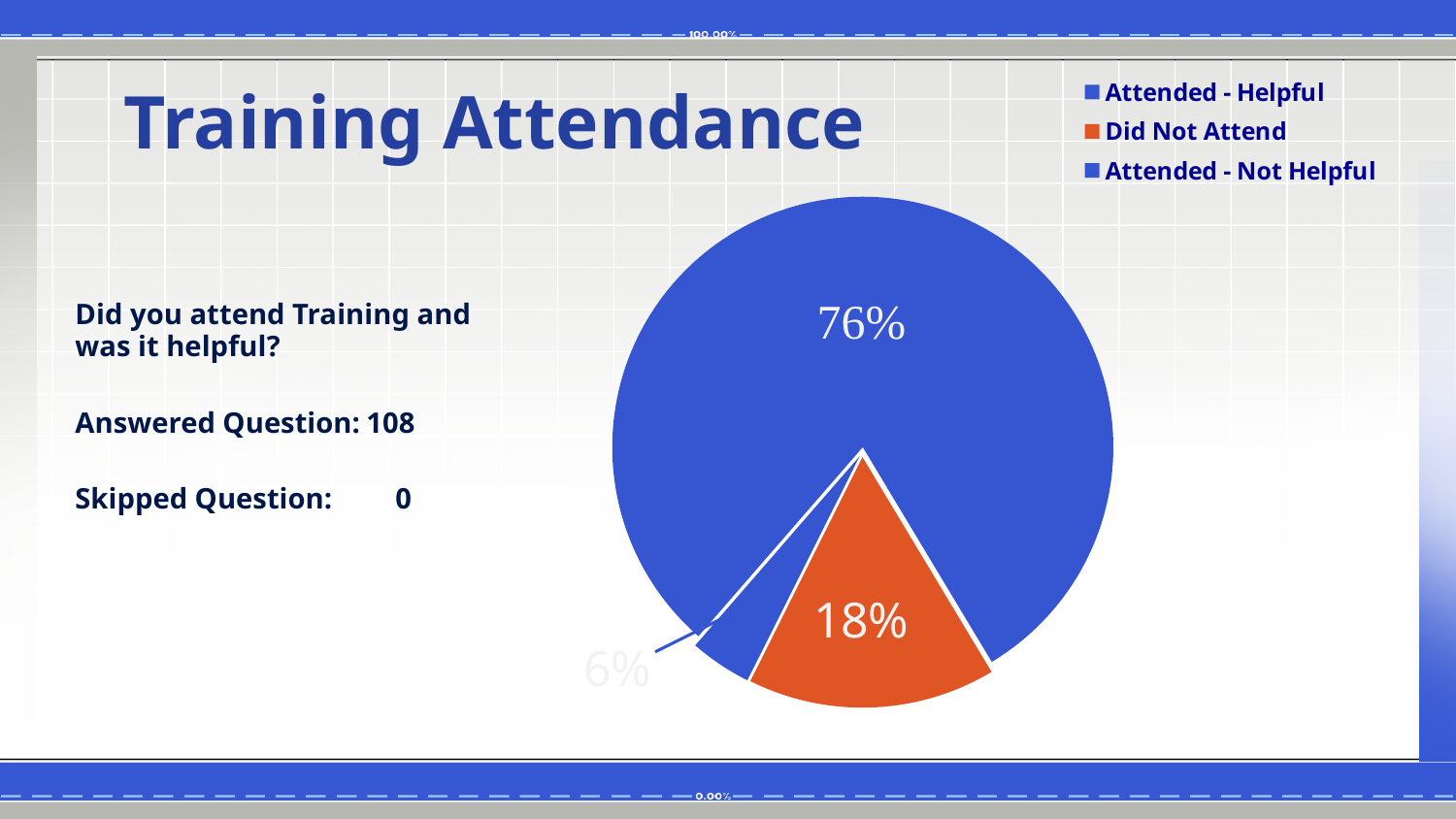
What is the difference in percentage points between Attended - Helpful and Did Not Attend? 58 How many entries does the legend list? 3 What share of the pie is labelled for Attended - Not Helpful? 6% Which category has the smallest slice of the pie? Attended - Not Helpful How many slices does the pie chart have? 3 Which category has the largest slice of the pie? Attended - Helpful What share of the pie is labelled for Did Not Attend? 18% What is the difference in percentage points between Did Not Attend and Attended - Not Helpful? 12 What kind of chart is shown on the slide? pie chart Which is larger, the slice for Did Not Attend or the slice for Attended - Not Helpful? Did Not Attend What is the title of the chart on the slide? Training Attendance What share of the pie is labelled for Attended - Helpful? 76%